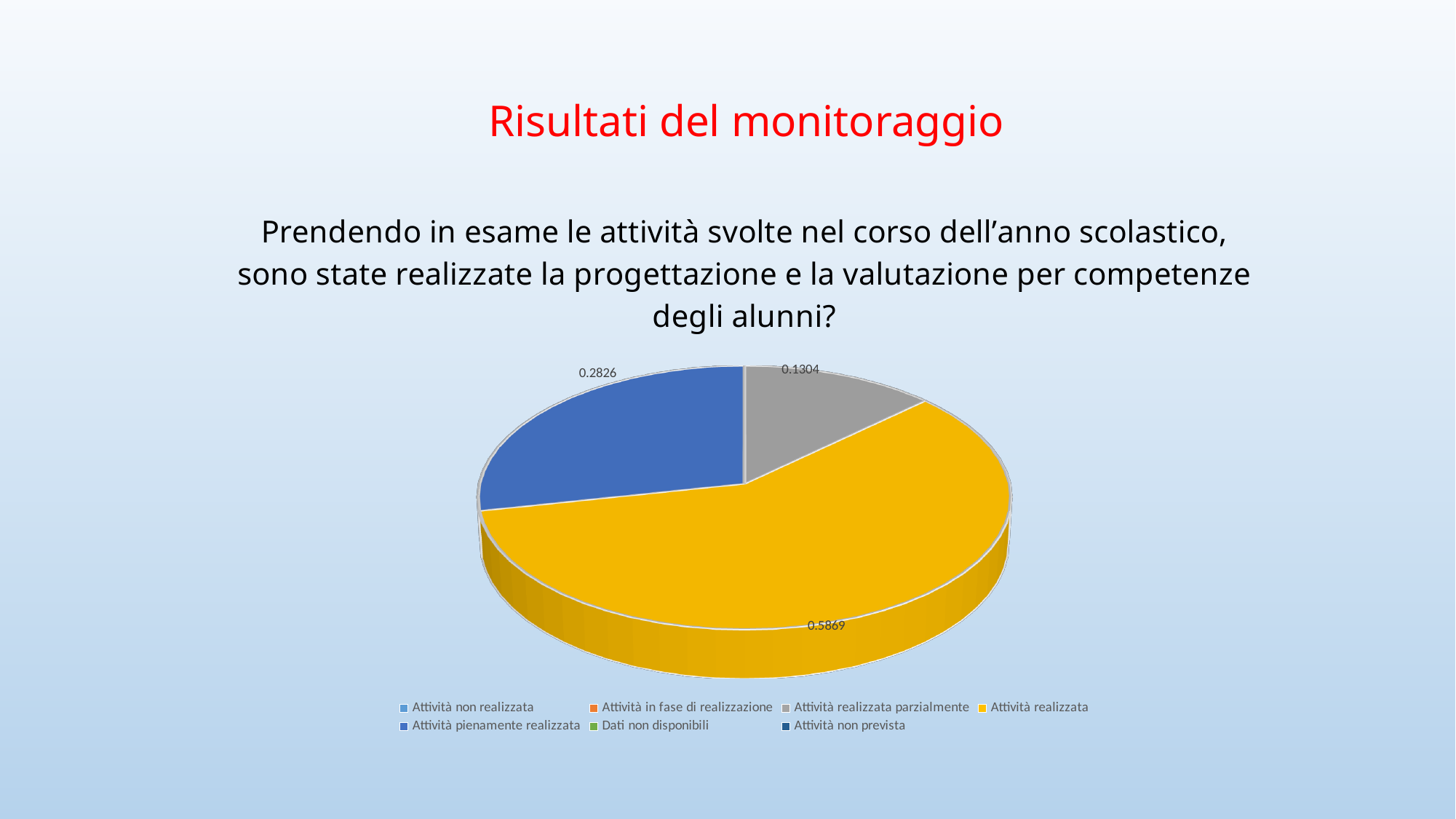
What colour is the 'Attività realizzata' slice? yellow Which category has the largest slice of the pie? Attività realizzata What is the value shown for the 'Attività realizzata parzialmente' slice? 0.1304 How many entries does the legend list? 7 How many slices with data labels are visible in the pie chart? 3 What is the value shown for the 'Attività pienamente realizzata' slice? 0.2826 What is the difference between the values for 'Attività pienamente realizzata' and 'Attività realizzata parzialmente'? 0.1522 What kind of chart is shown on the slide? pie chart Which of the labelled slices is the smallest? Attività realizzata parzialmente Which is larger, the 'Attività pienamente realizzata' slice or the 'Attività realizzata parzialmente' slice? Attività pienamente realizzata What is the difference between the values for 'Attività realizzata' and 'Attività pienamente realizzata'? 0.3043 What is the value shown for the 'Attività realizzata' slice? 0.5869